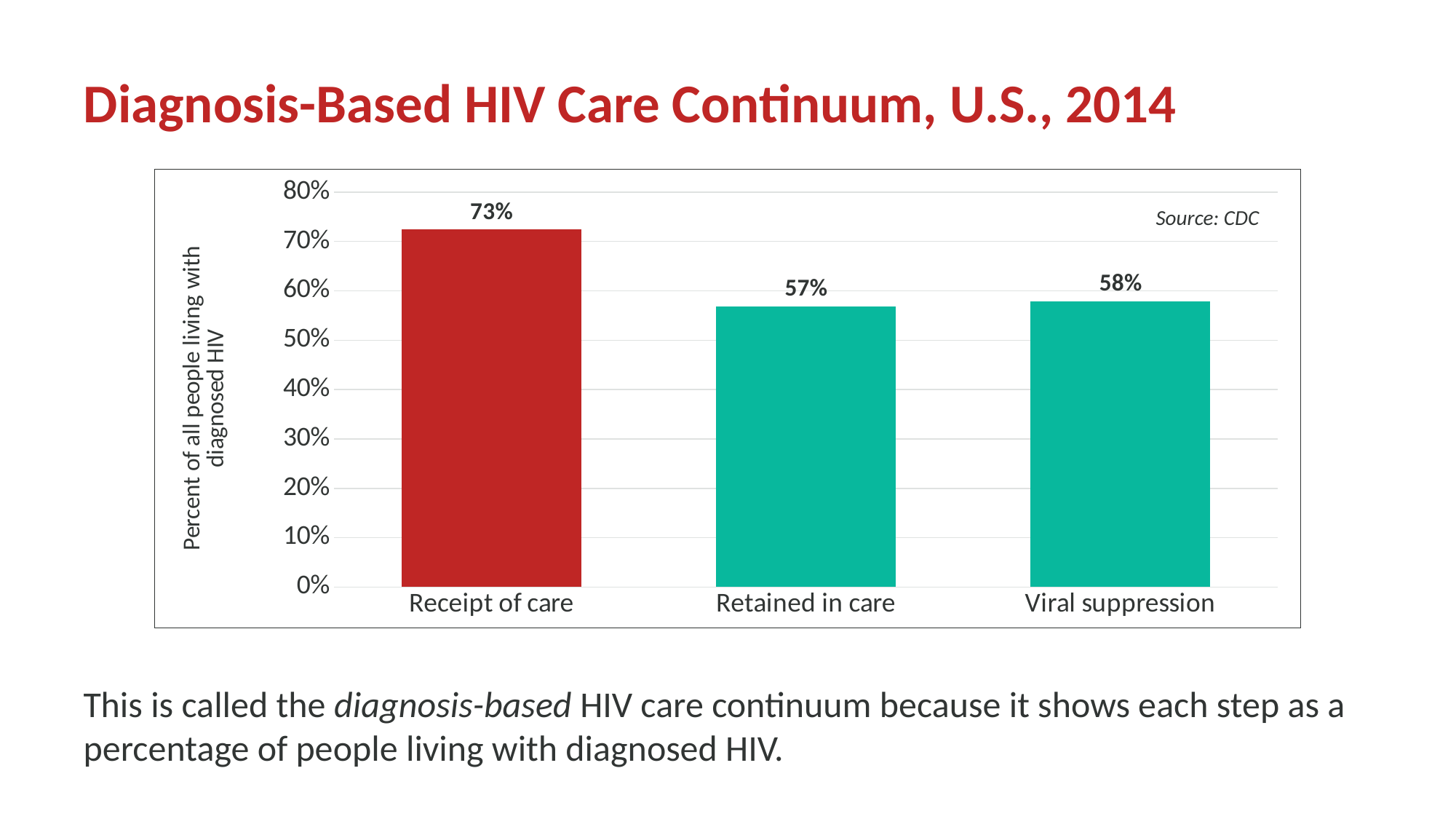
What is the difference between the values for Viral suppression and Retained in care? 1% What is the difference between the values for Receipt of care and Retained in care? 16% Which category has the highest value? Receipt of care Which is larger, the value for Receipt of care or the value for Viral suppression? Receipt of care What is the value for Receipt of care? 73% Which category has the lowest value? Retained in care What is the title of the chart? Diagnosis-Based HIV Care Continuum, U.S., 2014 What kind of chart is shown on the slide? bar chart What is the value for Viral suppression? 58% How many categories are shown on the x axis? 3 Is the value for Retained in care greater or less than 60%? less What is the value for Retained in care? 57%